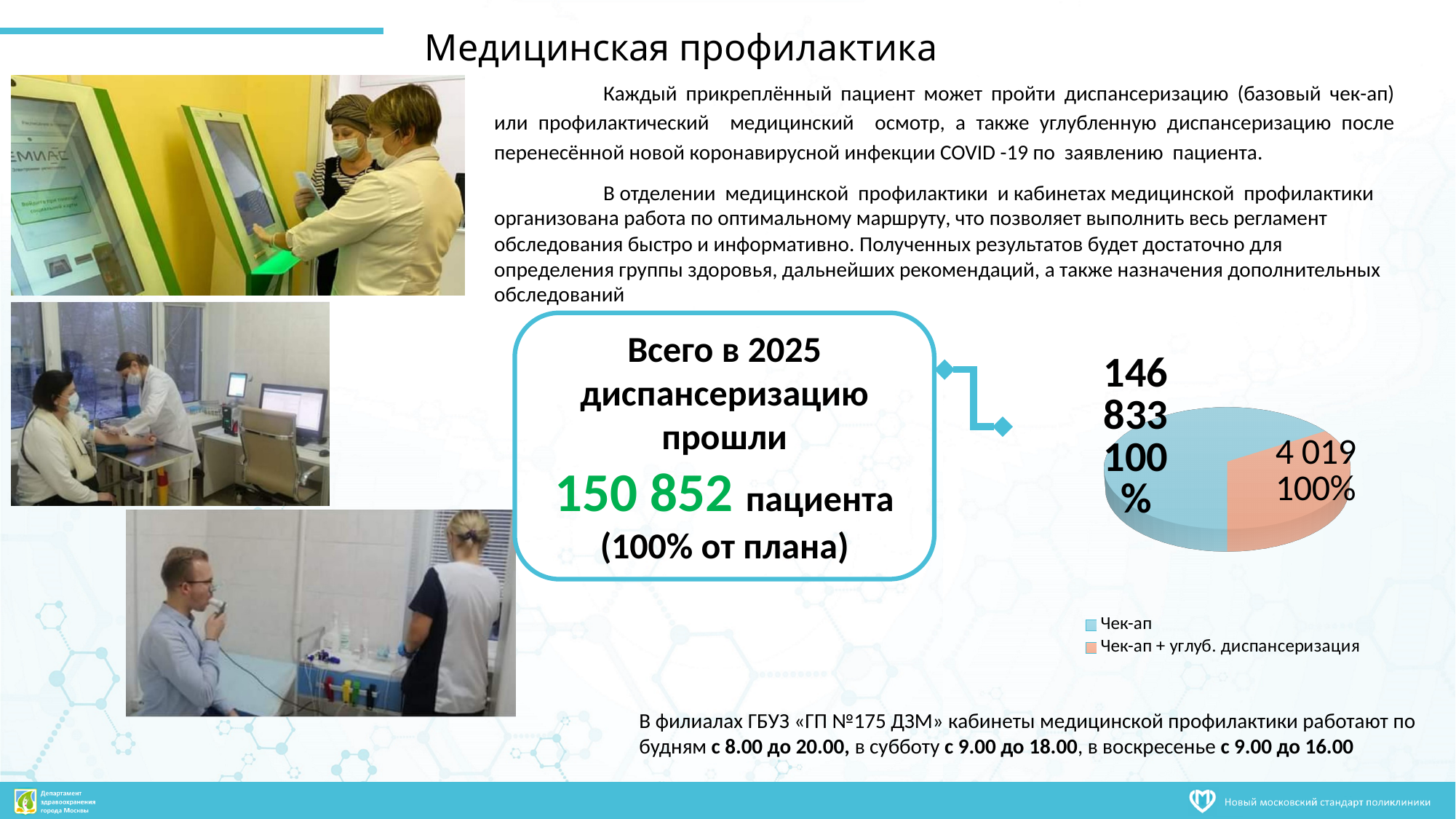
Which slice of the pie chart is the largest? Чек-ап What colour is the Чек-ап slice in the pie chart? light blue Which is larger in the pie chart: Чек-ап or Чек-ап + углуб. диспансеризация? Чек-ап What colour is the Чек-ап + углуб. диспансеризация slice in the pie chart? orange (salmon) What percentage label is printed next to the Чек-ап slice of the pie chart? 100% What value is shown for the Чек-ап slice of the pie chart? 146 833 How many entries does the legend of the pie chart list? 2 What value is shown for the Чек-ап + углуб. диспансеризация slice of the pie chart? 4 019 What is the difference between the Чек-ап value and the Чек-ап + углуб. диспансеризация value in the pie chart? 142 814 How many slices does the pie chart have? 2 What kind of chart is shown on the right side of the slide? pie chart Which slice of the pie chart is the smallest? Чек-ап + углуб. диспансеризация